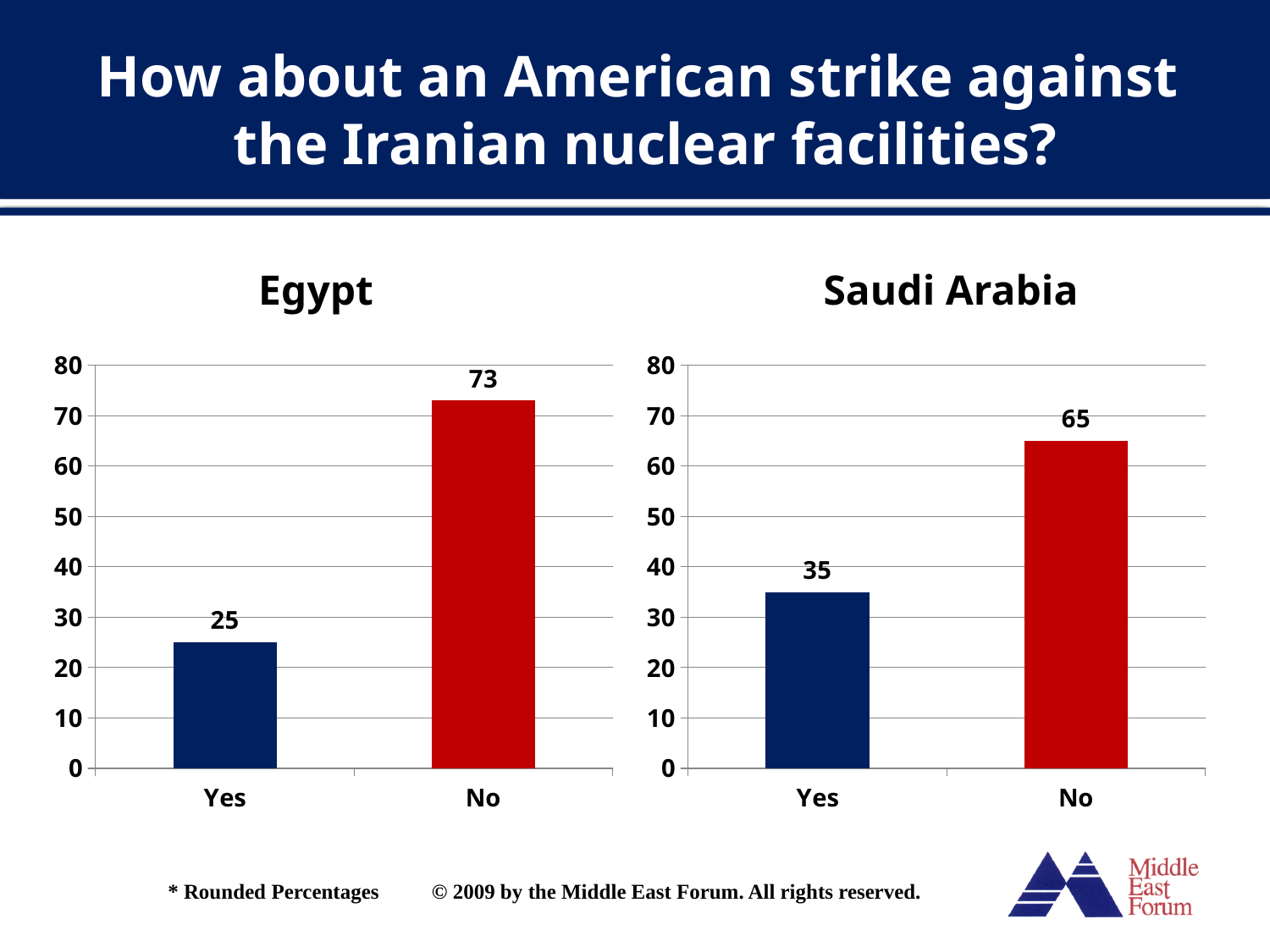
In the Egypt chart, what is the difference between the No and Yes values? 48 In the Egypt chart, which category has the highest value? No In the Saudi Arabia chart, which category has the lowest value? Yes In the Saudi Arabia chart, what is the value for Yes? 35 In the Egypt chart, is the value for No greater or less than 70? greater How many categories are shown in the Saudi Arabia chart? 2 Which is larger: the Yes value in the Egypt chart or the Yes value in the Saudi Arabia chart? Saudi Arabia In the Saudi Arabia chart, what is the difference between the No and Yes values? 30 In the Egypt chart, what is the value for No? 73 In the Saudi Arabia chart, what is the value for No? 65 In the Egypt chart, what is the value for Yes? 25 What kind of chart is the Egypt chart? Bar chart